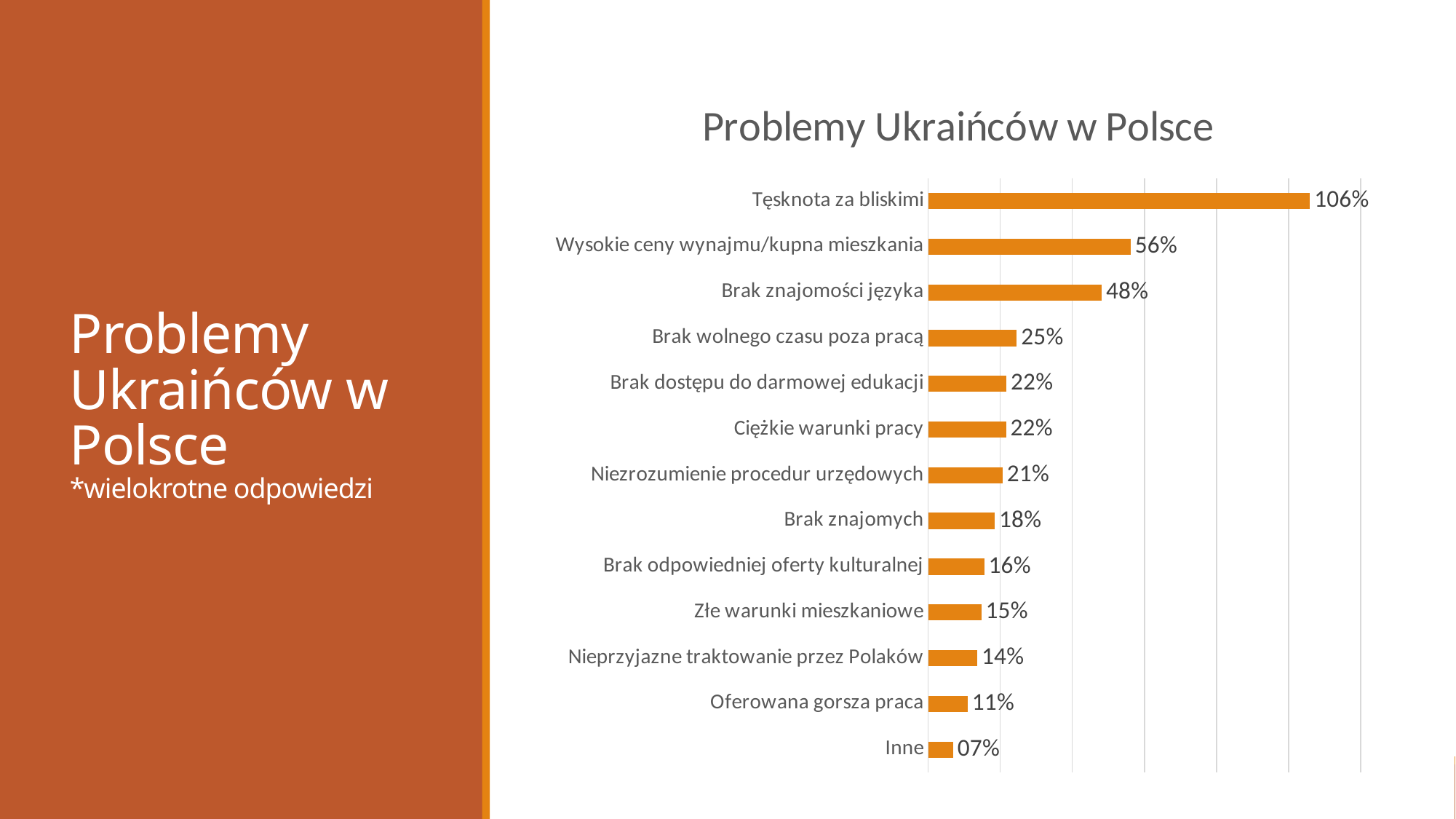
What is the title of the chart? Problemy Ukraińców w Polsce What is the value for Nieprzyjazne traktowanie przez Polaków? 14% Which is larger, Brak znajomości języka or Brak wolnego czasu poza pracą? Brak znajomości języka How many categories are shown in the chart? 13 What is the value for Inne? 07% What is the difference between Brak wolnego czasu poza pracą and Brak znajomych? 7% What kind of chart is this? Bar chart Which category has the lowest value? Inne What is the difference between Tęsknota za bliskimi and Wysokie ceny wynajmu/kupna mieszkania? 50% Which category has the highest value? Tęsknota za bliskimi What is the value for Brak znajomości języka? 48% What is the value for Tęsknota za bliskimi? 106%